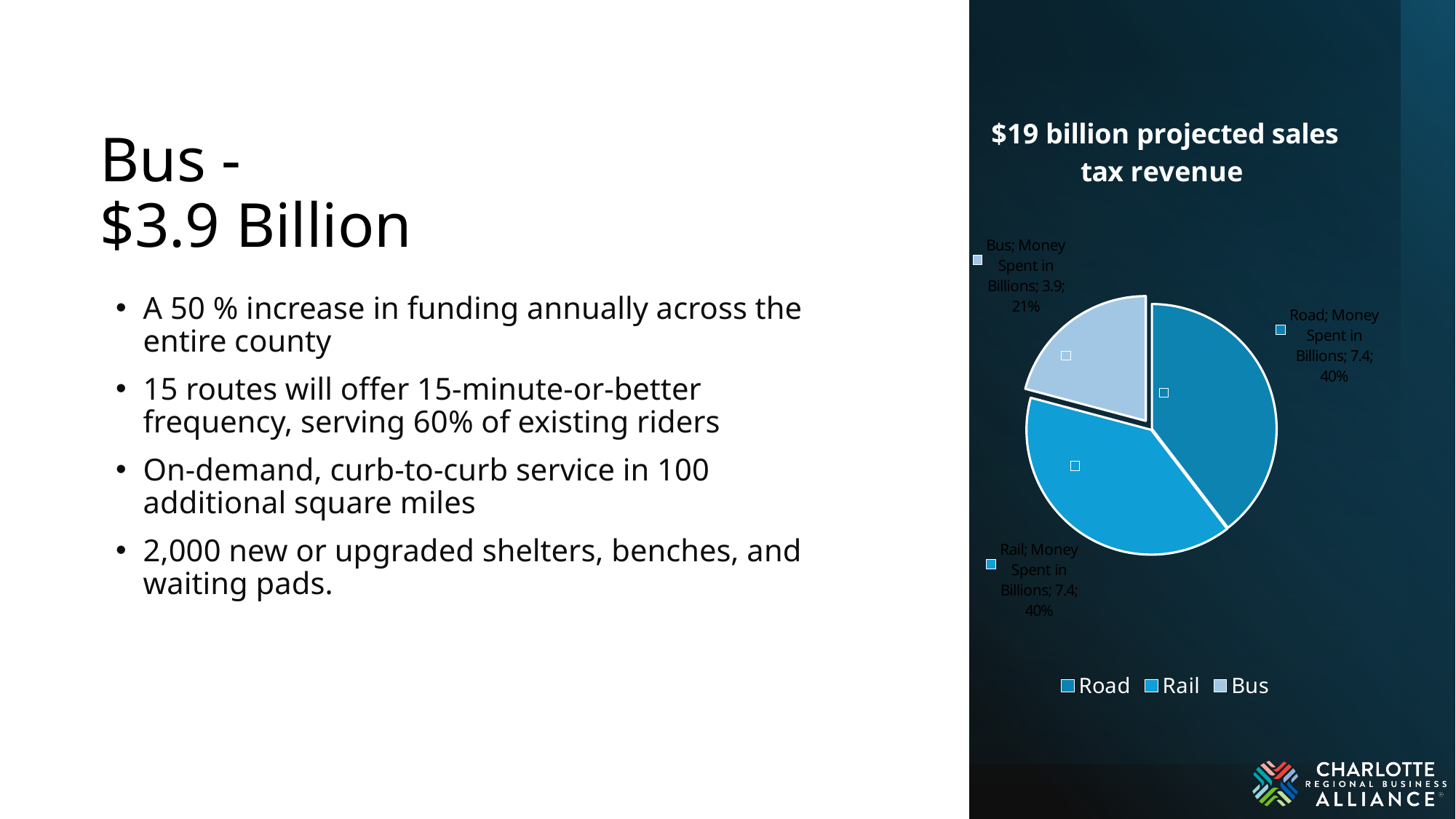
Which category has the smallest slice in the pie chart? Bus How many entries does the chart legend list? 3 What share of the pie does the Bus slice represent? 21% How many slices does the pie chart have? 3 What is the title of the chart? $19 billion projected sales tax revenue Which is larger, the Road slice or the Bus slice? Road What is the value for Bus in the pie chart? 3.9 What is the value for Road in the pie chart? 7.4 Which legend entry is shown in the lightest blue colour? Bus What is the difference between the Road value and the Bus value? 3.5 What share of the pie does the Rail slice represent? 40% What kind of chart is shown on the slide? pie chart